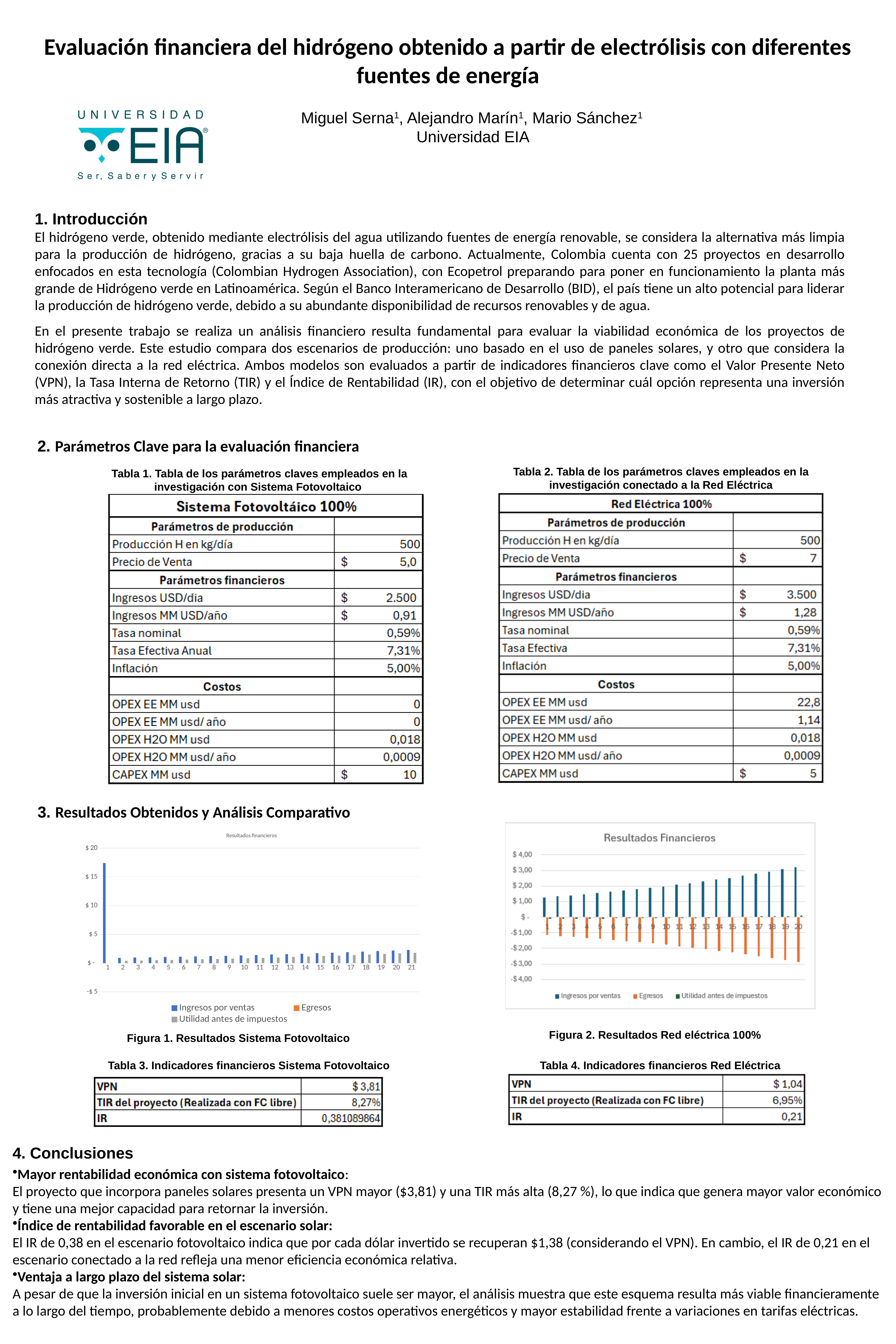
What kind of chart is Figura 2 (Resultados Red eléctrica 100%)? bar chart In Figura 2 (Resultados Red eléctrica 100%), is the Ingresos por ventas value at period 20 greater or less than $2,00? greater In Figura 2 (Resultados Red eléctrica 100%), which period has the highest Ingresos por ventas value? 20 In Figura 2 (Resultados Red eléctrica 100%), do the Ingresos por ventas values rise or fall from period 1 to period 20? rise What is the title shown on the chart in Figura 2 (Resultados Red eléctrica 100%)? Resultados Financieros How many series does the legend of Figura 2 (Resultados Red eléctrica 100%) list? 3 What kind of chart is Figura 1 (Resultados Sistema Fotovoltaico)? bar chart How many periods are shown on the x axis of Figura 2 (Resultados Red eléctrica 100%)? 20 In Figura 2 (Resultados Red eléctrica 100%), is the Ingresos por ventas value at period 1 greater or less than $2,00? less In Figura 1 (Resultados Sistema Fotovoltaico), is the tall blue bar at period 1 greater or less than $15? greater How many periods are shown on the x axis of Figura 1 (Resultados Sistema Fotovoltaico)? 21 How many series does the legend of Figura 1 (Resultados Sistema Fotovoltaico) list? 3